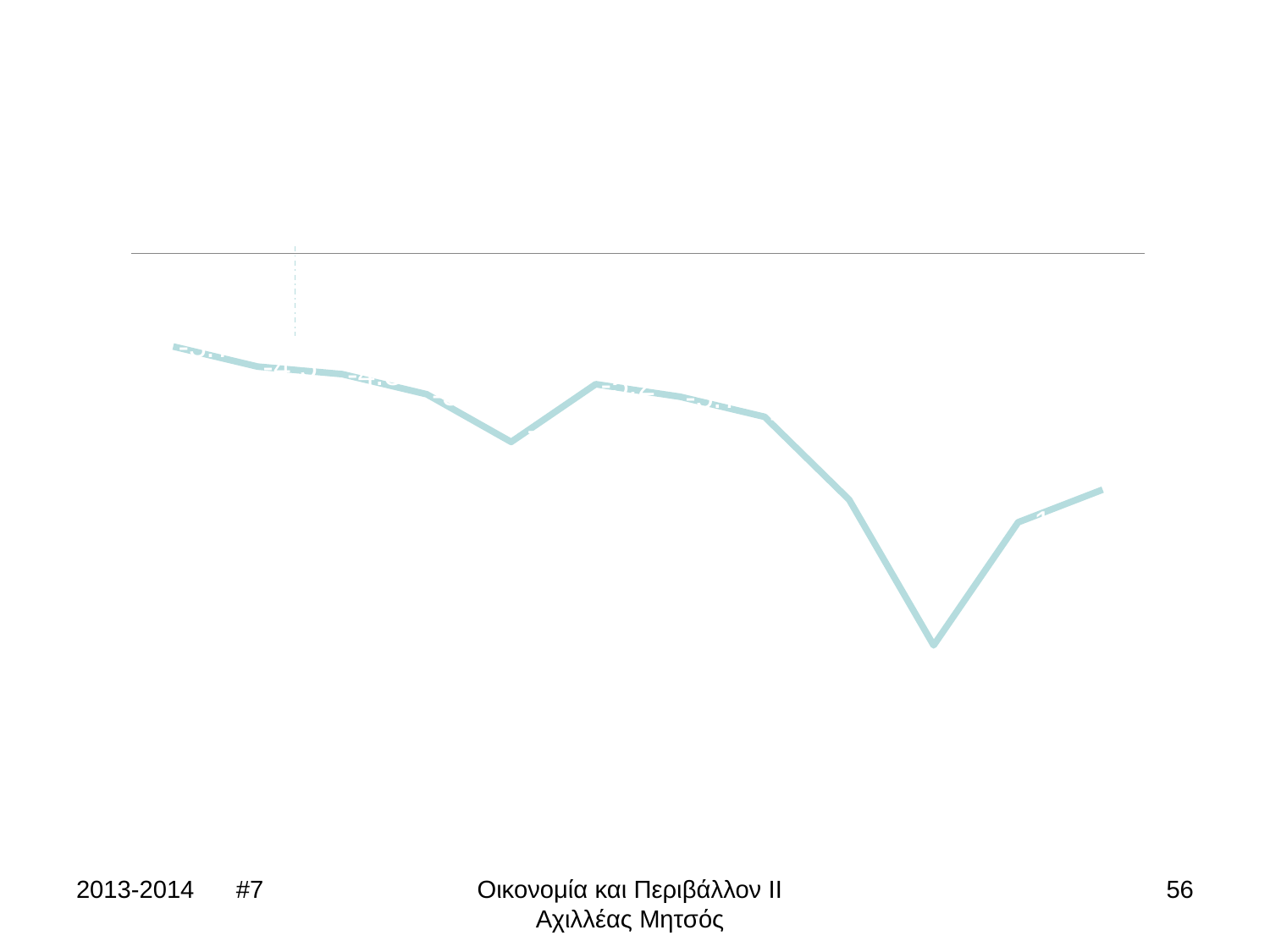
What kind of chart is shown on the slide? line chart How many lines (series) are plotted on the chart? 1 Does the line chart have a legend? No Do the values on the line chart overall rise or fall from left to right? fall How many data points does the line on the chart have? 12